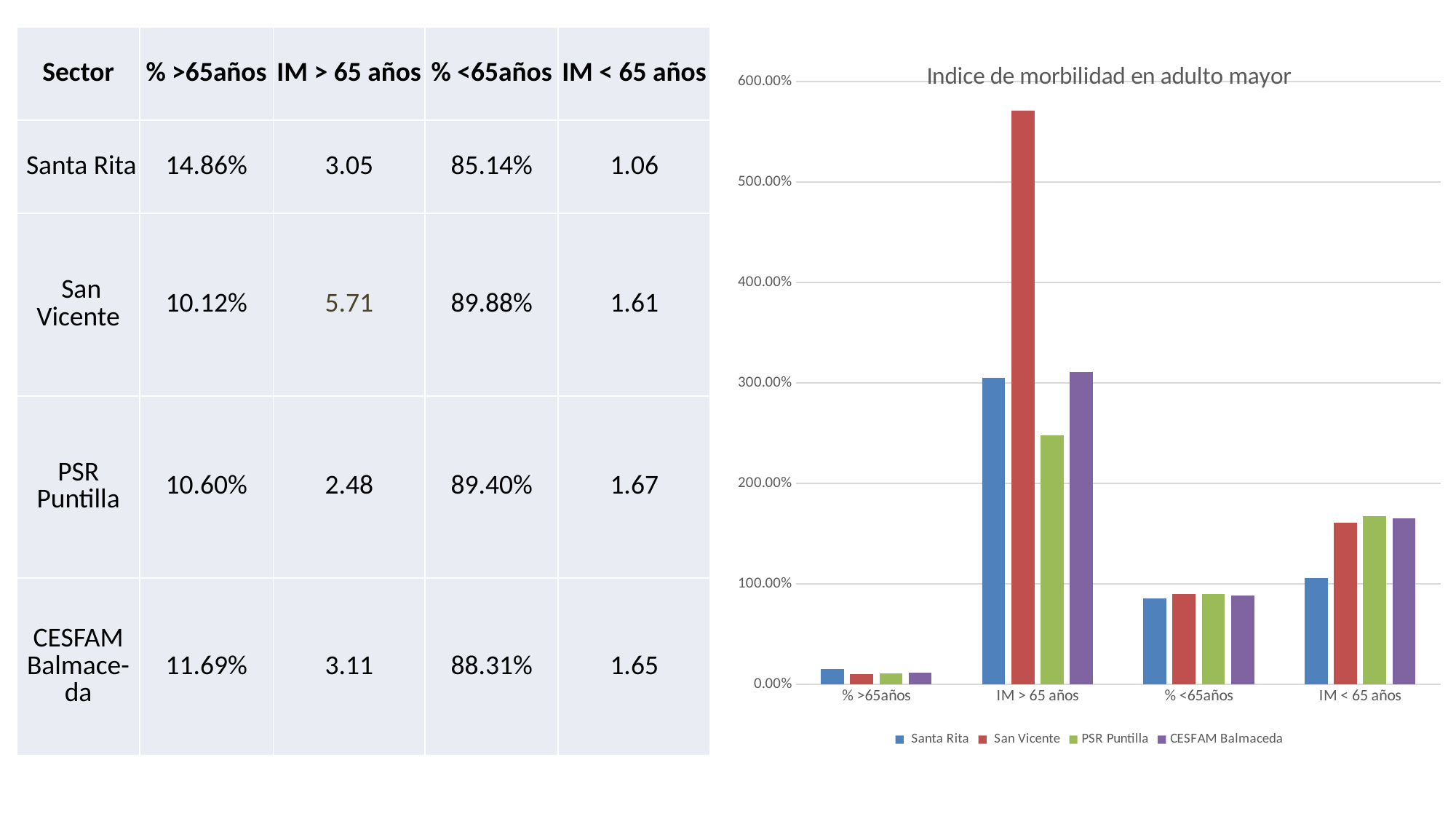
What kind of chart is shown on the slide? bar chart Is the value for PSR Puntilla in IM > 65 años greater or less than 300.00%? less Is the value for San Vicente in IM > 65 años greater or less than 500.00%? greater What is the title of the chart? Indice de morbilidad en adulto mayor How many categories are shown on the x axis of the chart? 4 Which colour represents San Vicente in the chart? red Is the value for Santa Rita in IM < 65 años greater or less than 200.00%? less How many series does the chart legend list? 4 In the IM < 65 años category, which is larger: Santa Rita or San Vicente? San Vicente Which series has the highest bar in the IM > 65 años category? San Vicente Which series has the lowest bar in the IM > 65 años category? PSR Puntilla